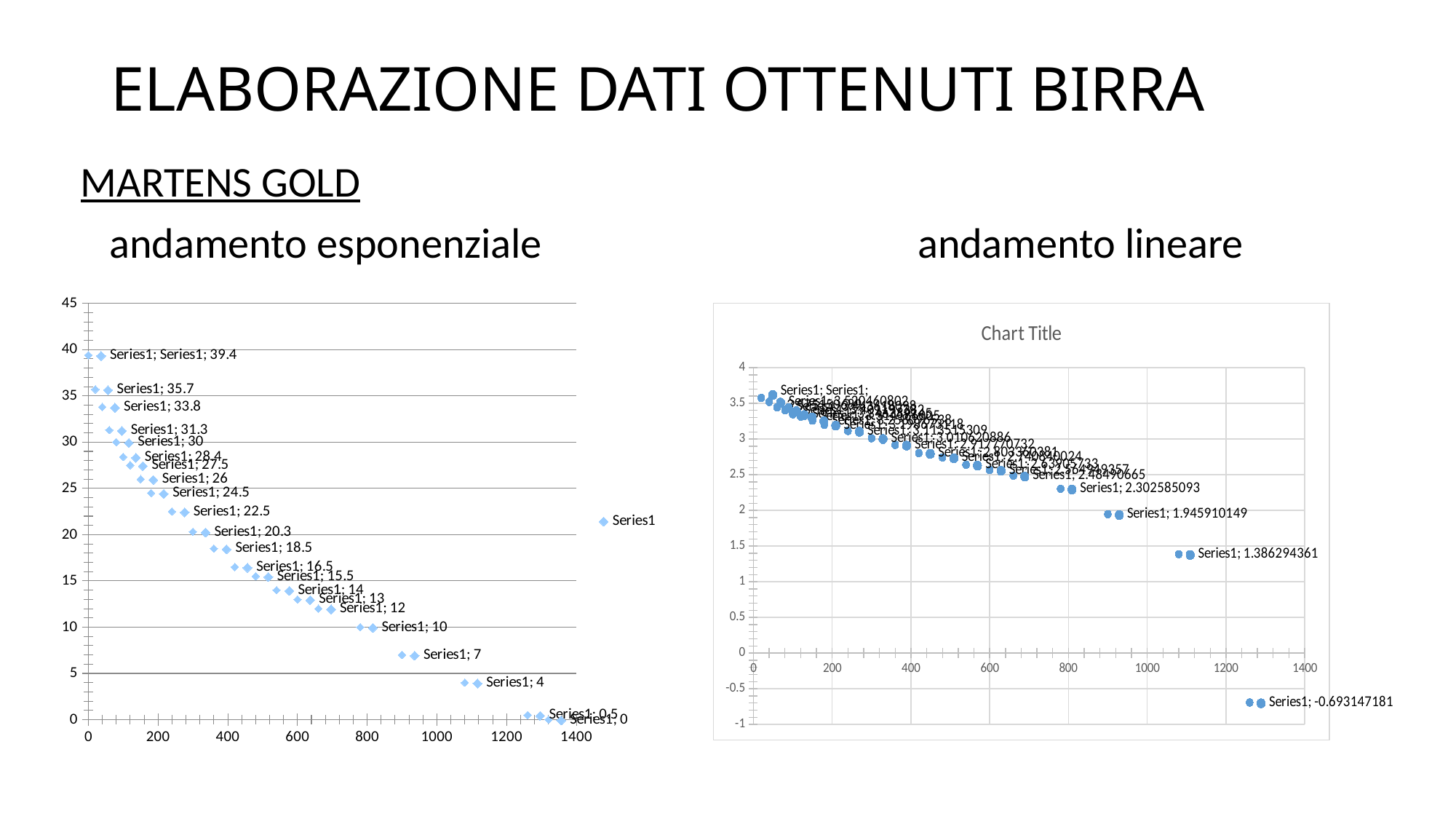
On the right chart (andamento lineare), what is the lowest labelled data value? -0.693147181 On the right chart (andamento lineare), what labelled value appears for the points near x = 1100? 1.386294361 What kind of chart is the left chart (andamento esponenziale)? scatter chart On the left chart (andamento esponenziale), is the labelled value 22.5 larger or smaller than the labelled value 20.3? larger On the left chart (andamento esponenziale), how many series does the legend list? 1 On the left chart (andamento esponenziale), what is the difference between the two highest labelled values, 39.4 and 35.7? 3.7 On the left chart (andamento esponenziale), what is the highest labelled data value? 39.4 What is the title shown on the right chart (andamento lineare)? Chart Title On the right chart (andamento lineare), do the values rise or fall as x increases? fall On the left chart (andamento esponenziale), what is the lowest labelled data value? 0 On the right chart (andamento lineare), is the value of the points near x = 900 greater or less than 1.5? greater On the left chart (andamento esponenziale), do the values rise or fall as x increases? fall